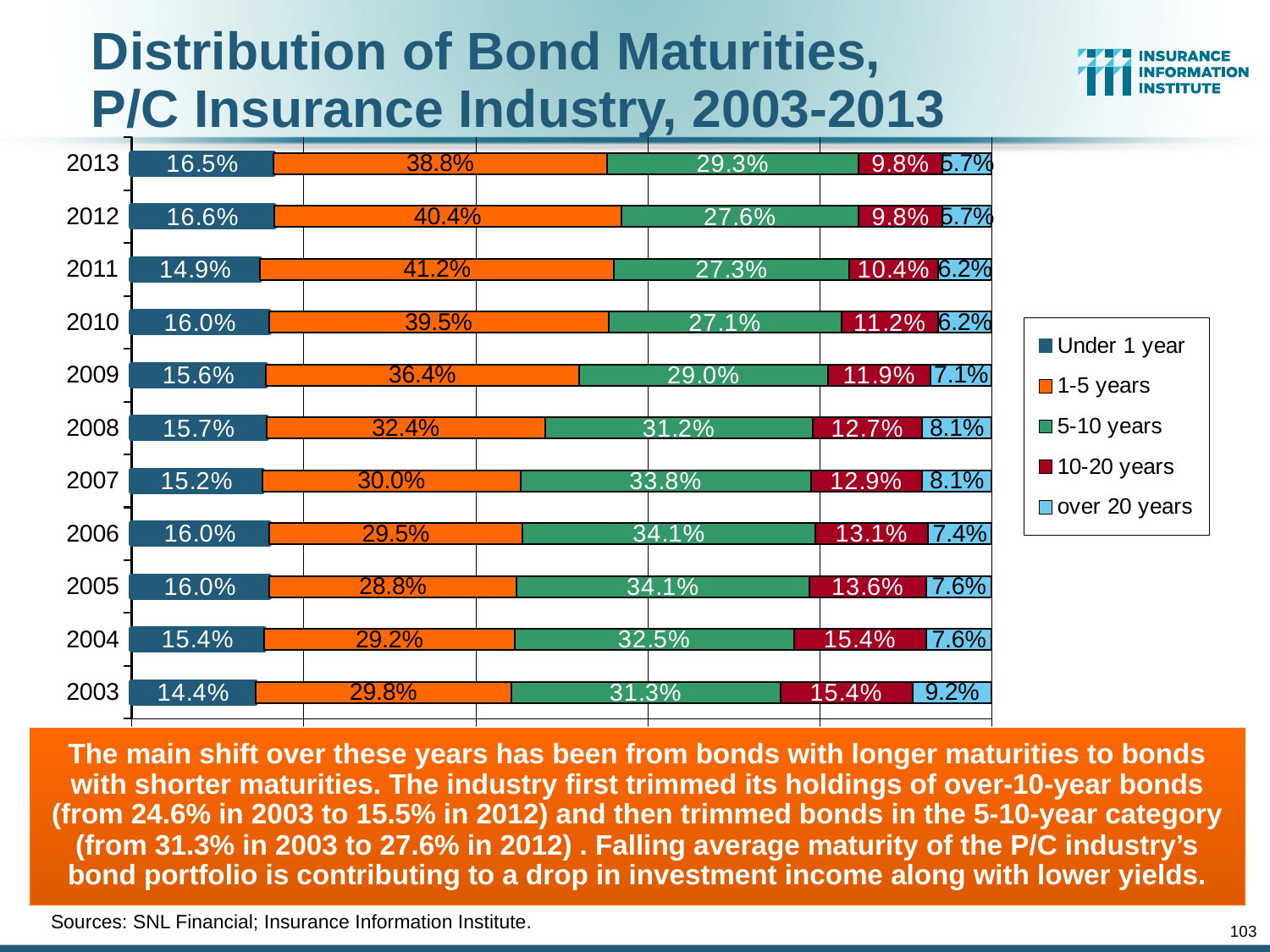
By how many percentage points did the 10-20 years share fall from 2003 to 2013? 5.6 percentage points In which year was the 1-5 years share the highest? 2011 What share of bonds had maturities of 1-5 years in 2013? 38.8% How many series does the legend list? 5 What was the over 20 years share in 2003? 9.2% Which was larger in 2008: the 1-5 years share or the 5-10 years share? 1-5 years How many years are shown on the chart? 11 What kind of chart is shown on the slide? Stacked bar chart Did the 1-5 years share generally rise or fall from 2003 to 2013? Rise In which year was the Under 1 year share the lowest? 2003 What was the 5-10 years share in 2006? 34.1% What was the combined share of 10-20 years and over 20 years bonds in 2003? 24.6%